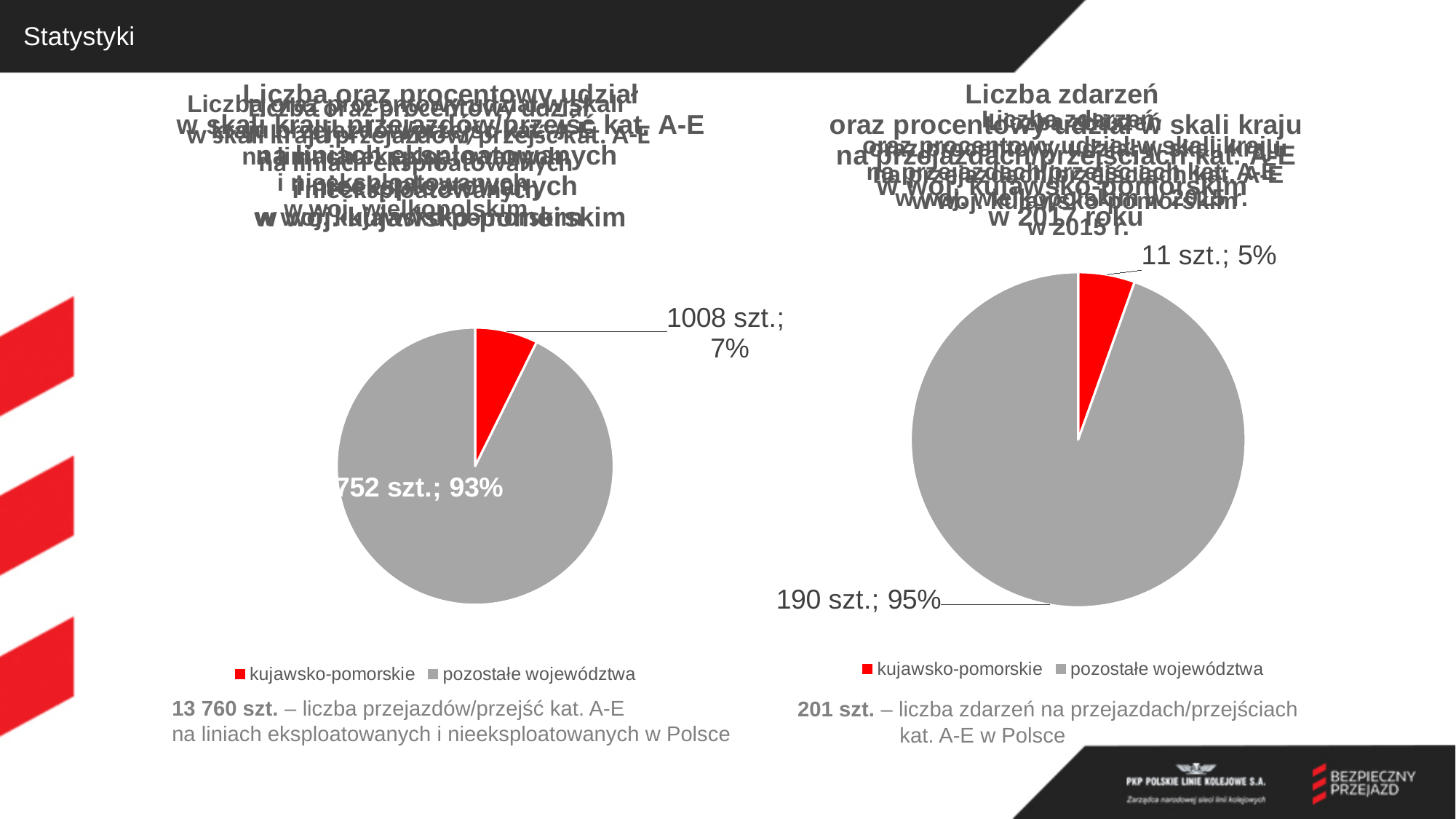
In the right pie chart, which colour represents kujawsko-pomorskie? red In the left pie chart, what percentage share does kujawsko-pomorskie have? 7% How many slices does the left pie chart have? 2 In the right pie chart, what is the difference between the values for pozostałe województwa and kujawsko-pomorskie? 179 szt. In the left pie chart, what percentage share does pozostałe województwa have? 93% In the right pie chart, what percentage share does kujawsko-pomorskie have? 5% How many entries does the legend of the right pie chart list? 2 In the left pie chart, what value is shown for kujawsko-pomorskie? 1008 szt. In the right pie chart, what value is shown for kujawsko-pomorskie? 11 szt. What kind of chart is the left chart on the slide? pie chart In the left pie chart, which slice is larger: kujawsko-pomorskie or pozostałe województwa? pozostałe województwa In the right pie chart, what value is shown for pozostałe województwa? 190 szt.